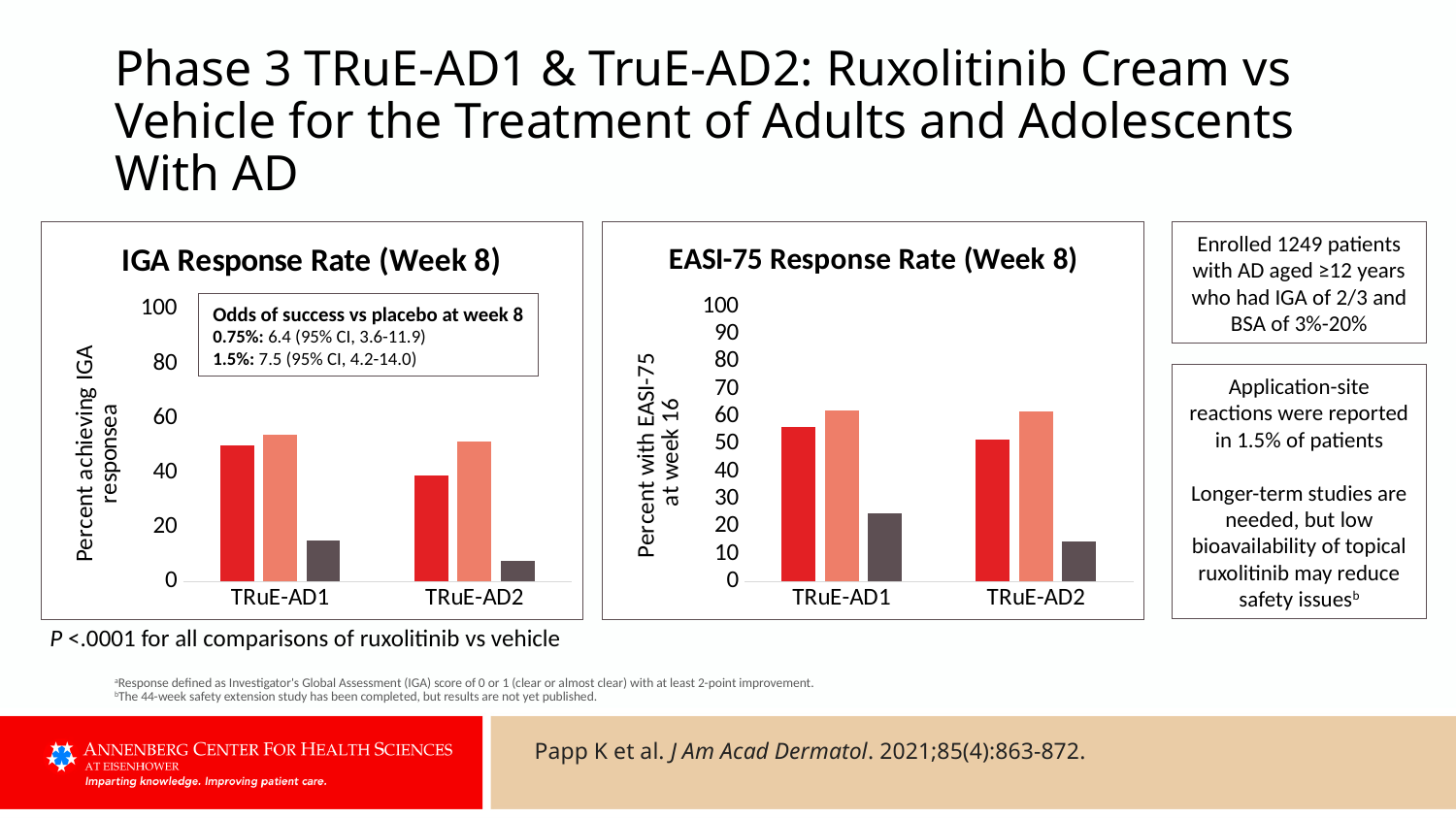
What is the title of the chart on the left of the slide? IGA Response Rate (Week 8) In the IGA Response Rate (Week 8) chart, which of the three bars for TRuE-AD2 is the tallest? the salmon (middle) bar What kind of chart is the IGA Response Rate (Week 8) chart? bar chart In the IGA Response Rate (Week 8) chart, which category has the larger dark gray bar, TRuE-AD1 or TRuE-AD2? TRuE-AD1 In the EASI-75 Response Rate (Week 8) chart, is the value of the salmon (middle) bar for TRuE-AD1 greater or less than 50? greater In the EASI-75 Response Rate (Week 8) chart, which category has the lower dark gray bar? TRuE-AD2 In the IGA Response Rate (Week 8) chart, is the value of the dark gray bar for TRuE-AD1 greater or less than 20? less In the EASI-75 Response Rate (Week 8) chart, how many bars are shown for each category? 3 In the IGA Response Rate (Week 8) chart, is the value of the red (first) bar for TRuE-AD2 greater or less than 20? greater How many categories are shown on the x axis of the IGA Response Rate (Week 8) chart? 2 What is the y-axis label of the EASI-75 Response Rate (Week 8) chart? Percent with EASI-75 at week 16